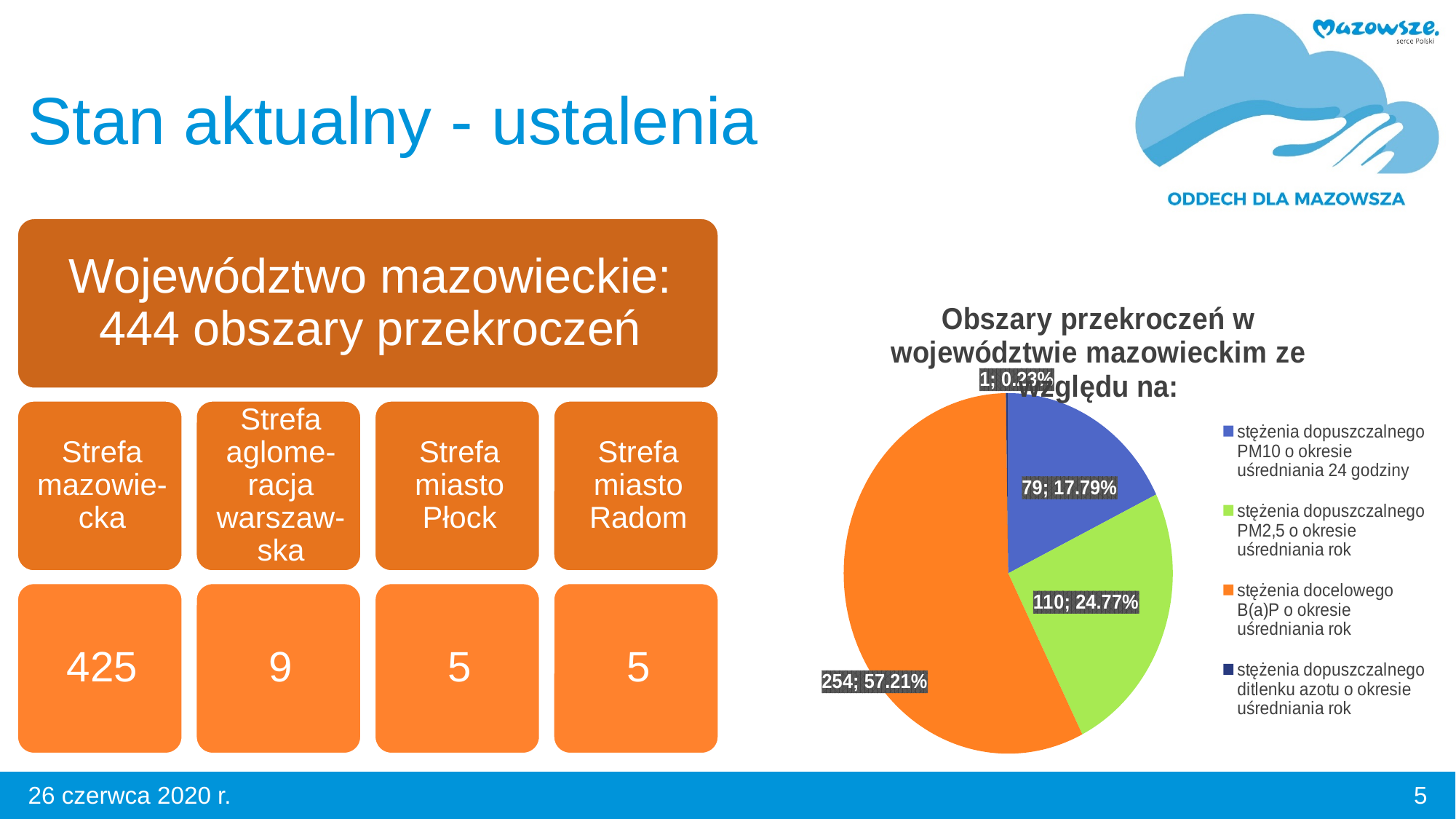
What is the value for 'stężenia docelowego B(a)P o okresie uśredniania rok' in the pie chart? 254 What share of the pie does 'stężenia dopuszczalnego ditlenku azotu o okresie uśredniania rok' represent? 0.23% How many slices does the pie chart have? 4 How many entries does the legend of the pie chart list? 4 Which is larger in the pie chart: the value for PM2,5 (rok) or the value for PM10 (24 godziny)? PM2,5 (rok) Which category has the smallest slice in the pie chart? stężenia dopuszczalnego ditlenku azotu o okresie uśredniania rok Which category has the largest slice in the pie chart? stężenia docelowego B(a)P o okresie uśredniania rok What is the value for 'stężenia dopuszczalnego PM2,5 o okresie uśredniania rok' in the pie chart? 110 What kind of chart is shown on the slide? pie chart What share of the pie does 'stężenia docelowego B(a)P o okresie uśredniania rok' represent? 57.21% What is the difference between the values for PM2,5 (rok) and PM10 (24 godziny) in the pie chart? 31 What is the value for 'stężenia dopuszczalnego PM10 o okresie uśredniania 24 godziny' in the pie chart? 79